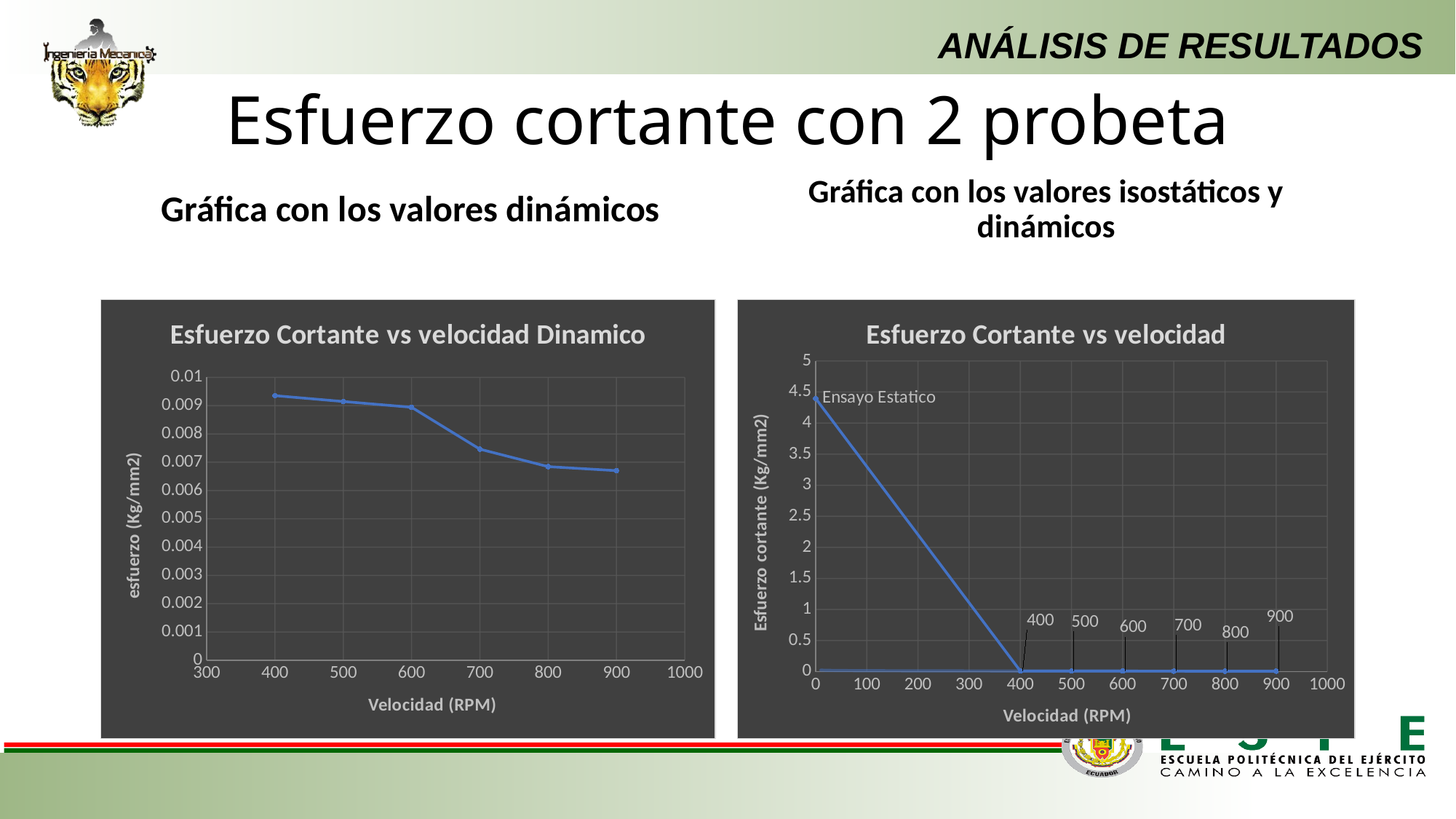
In the left chart 'Esfuerzo Cortante vs velocidad Dinamico', is the value at 900 RPM greater or less than 0.007? less In the left chart 'Esfuerzo Cortante vs velocidad Dinamico', is the value at 400 RPM greater or less than 0.009? greater What is the x-axis title of the left chart 'Esfuerzo Cortante vs velocidad Dinamico'? Velocidad (RPM) In the left chart 'Esfuerzo Cortante vs velocidad Dinamico', how many data points are plotted? 6 What kind of chart is the left chart titled 'Esfuerzo Cortante vs velocidad Dinamico'? Line chart In the left chart 'Esfuerzo Cortante vs velocidad Dinamico', at which velocity (RPM) is the esfuerzo lowest? 900 What kind of chart is the right chart titled 'Esfuerzo Cortante vs velocidad'? Line chart In the right chart 'Esfuerzo Cortante vs velocidad', which point has the highest esfuerzo cortante value? Ensayo Estatico In the left chart 'Esfuerzo Cortante vs velocidad Dinamico', do the values rise or fall as velocity increases from 400 to 900 RPM? Fall In the left chart 'Esfuerzo Cortante vs velocidad Dinamico', at which velocity (RPM) is the esfuerzo highest? 400 In the left chart 'Esfuerzo Cortante vs velocidad Dinamico', which has the larger esfuerzo value, 600 RPM or 800 RPM? 600 RPM In the right chart 'Esfuerzo Cortante vs velocidad', is the value of the point labelled 'Ensayo Estatico' greater or less than 4? greater